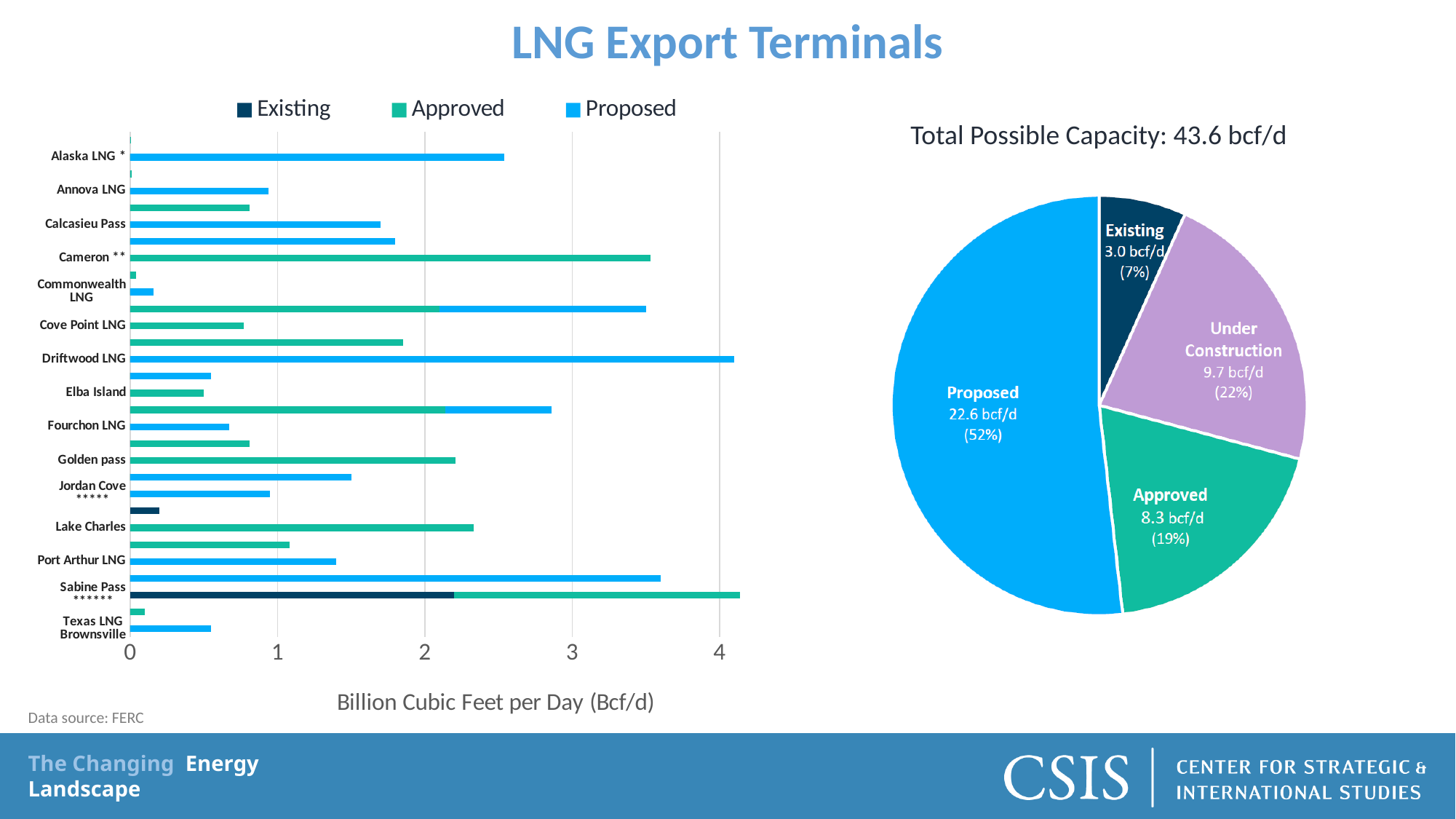
In the pie chart, which slice is the largest? Proposed In the pie chart, which slice is the smallest? Existing How many terminals are listed on the y axis of the bar chart on the left? 15 In the pie chart, what is the capacity for the Proposed slice? 22.6 bcf/d In the pie chart, which is larger, Approved or Under Construction? Under Construction In the pie chart, what is the capacity for the Existing slice? 3.0 bcf/d How many series does the legend of the bar chart on the left list? 3 What kind of chart is the chart on the left of the slide? Bar chart In the pie chart, what share of total possible capacity is Under Construction? 22% In the bar chart on the left, is the Approved value for Cameron ** greater or less than 3? greater In the pie chart, what is the difference in capacity between Under Construction and Approved? 1.4 bcf/d How many slices does the pie chart have? 4